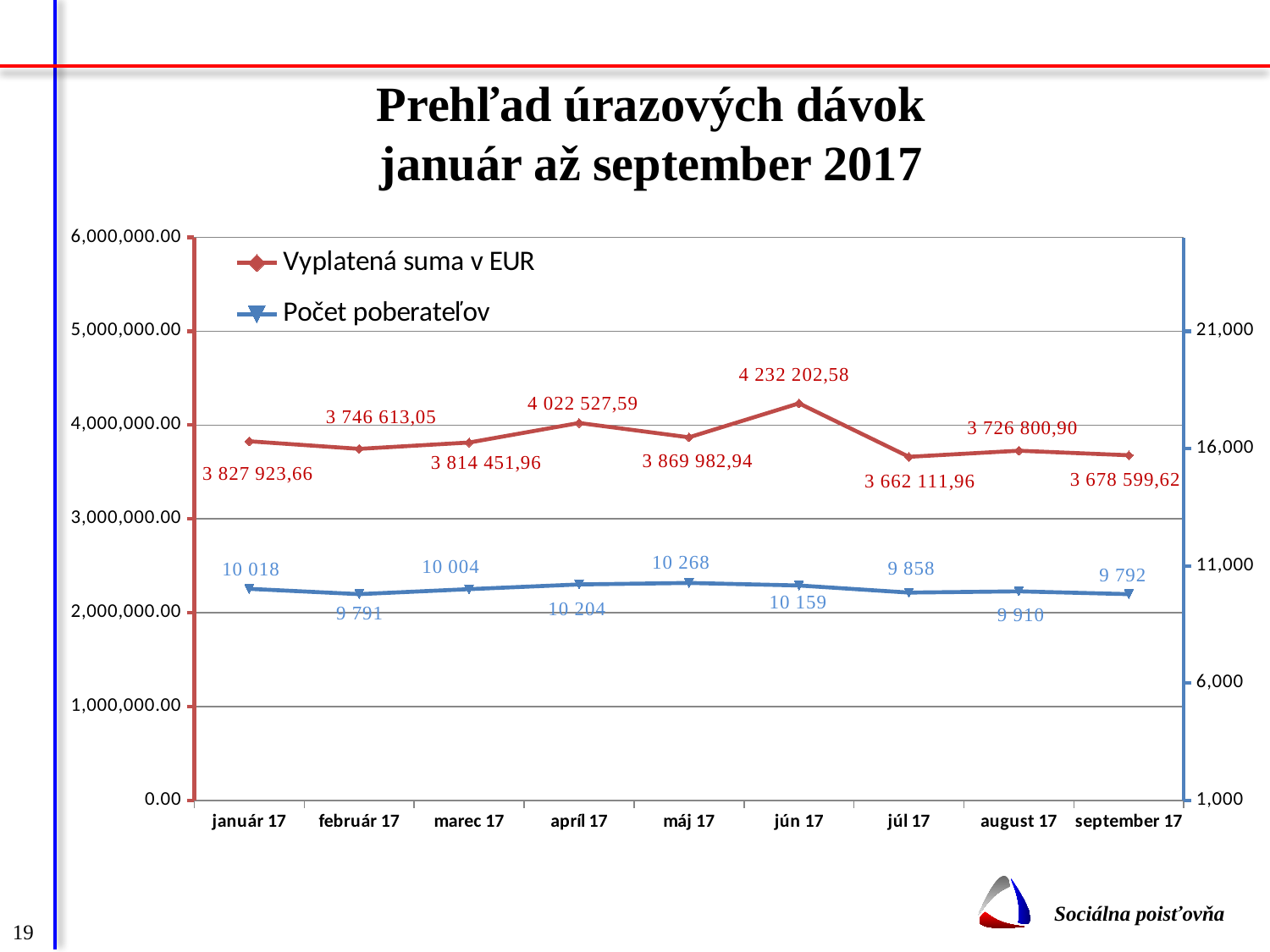
In which month is Počet poberateľov the highest? máj 17 What kind of chart is shown on the slide? line chart What is the difference in Vyplatená suma v EUR between jún 17 and júl 17? 570 090,62 What is the value of Vyplatená suma v EUR for január 17? 3 827 923,66 How many months are shown on the x axis? 9 What is the value of Vyplatená suma v EUR for jún 17? 4 232 202,58 In which month is Vyplatená suma v EUR the highest? jún 17 What is the value of Počet poberateľov for apríl 17? 10 204 Is the Vyplatená suma v EUR for jún 17 greater or less than 4,000,000.00? greater Which month has a higher Vyplatená suma v EUR, apríl 17 or máj 17? apríl 17 In which month is Vyplatená suma v EUR the lowest? júl 17 How many series does the legend list? 2